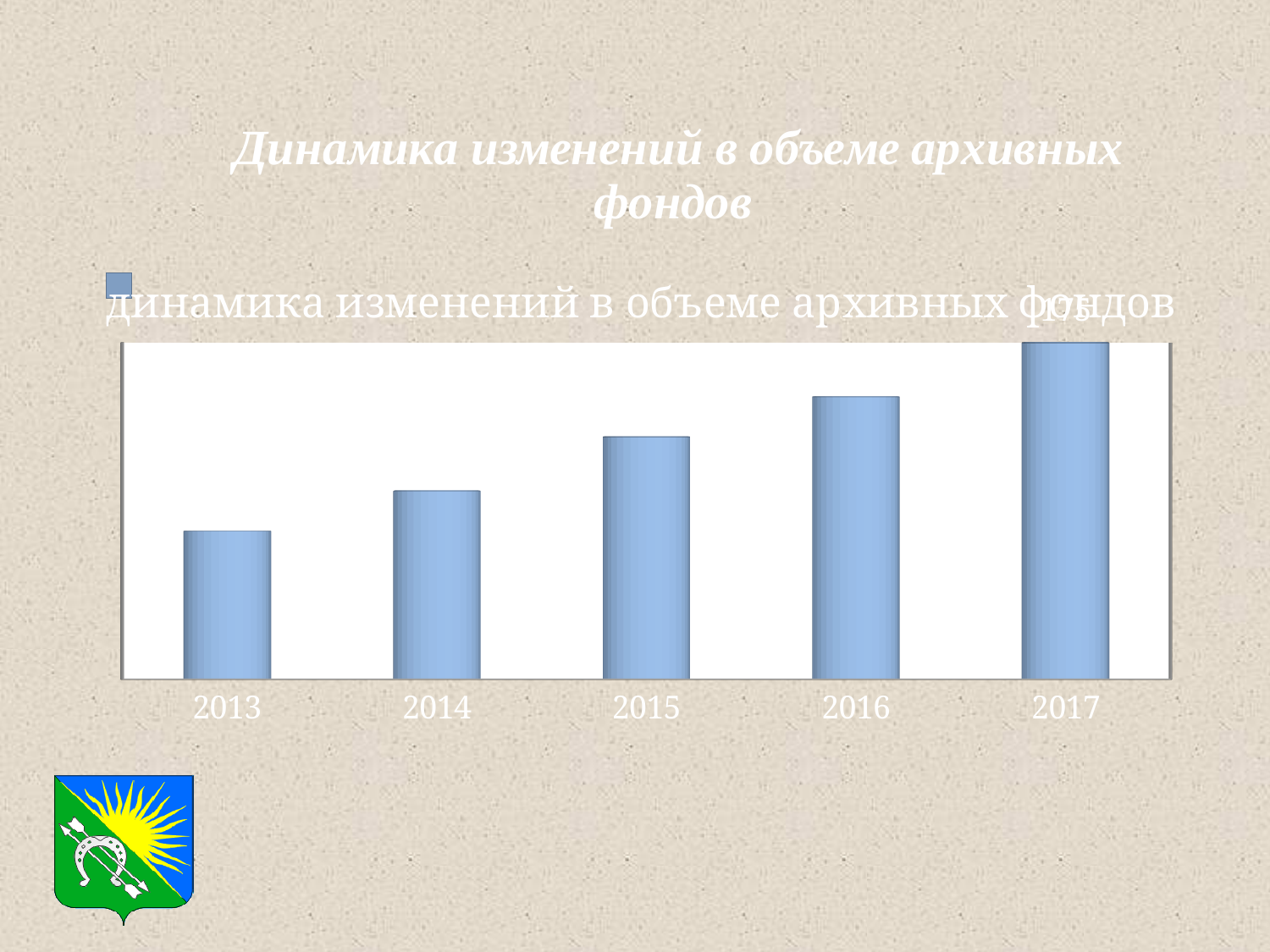
Which year has the highest bar in the chart? 2017 What is the first year shown on the x axis? 2013 What kind of chart is shown on the slide? bar chart How many years are shown on the x axis of the chart? 5 Which year has the lowest bar in the chart? 2013 Which year has the larger value, 2014 or 2016? 2016 Which year has the larger value, 2015 or 2013? 2015 How many series does the legend list? 1 Do the values rise or fall from 2013 to 2017? rise What colour are the bars in the chart? blue